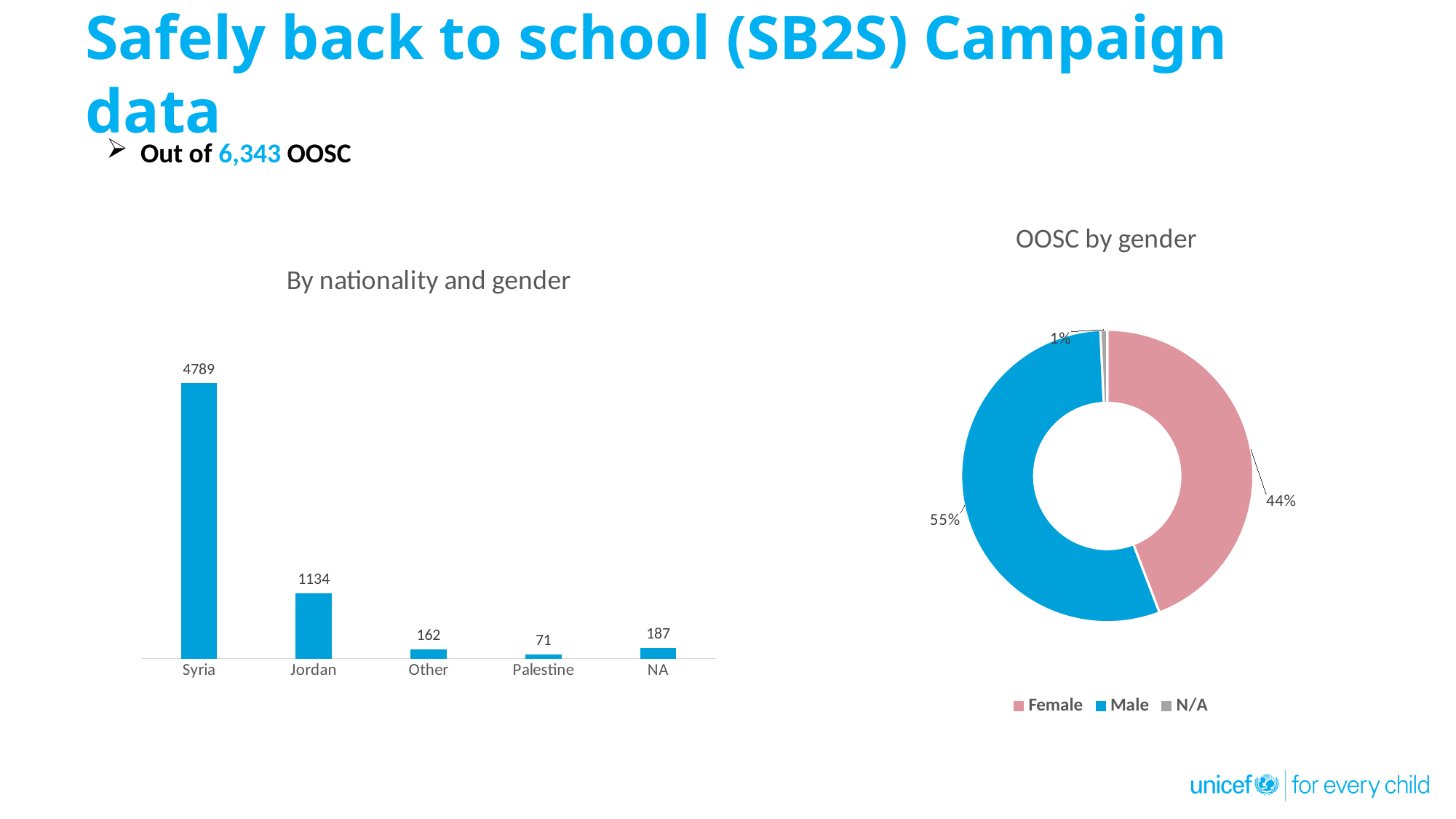
In the 'OOSC by gender' chart, what share is Male? 55% What kind of chart is the 'By nationality and gender' chart? Bar chart In the 'By nationality and gender' chart, what is the value for Palestine? 71 In the 'By nationality and gender' chart, what is the value for Syria? 4789 How many series does the legend of the 'OOSC by gender' chart list? 3 In the 'By nationality and gender' chart, which is larger, the value for Other or the value for NA? NA How many categories are shown in the 'By nationality and gender' chart? 5 In the 'By nationality and gender' chart, what is the difference between the values for Syria and Jordan? 3655 In the 'By nationality and gender' chart, which category has the highest value? Syria In the 'By nationality and gender' chart, which category has the lowest value? Palestine In the 'OOSC by gender' chart, what share is Female? 44% In the 'By nationality and gender' chart, what is the value for Jordan? 1134